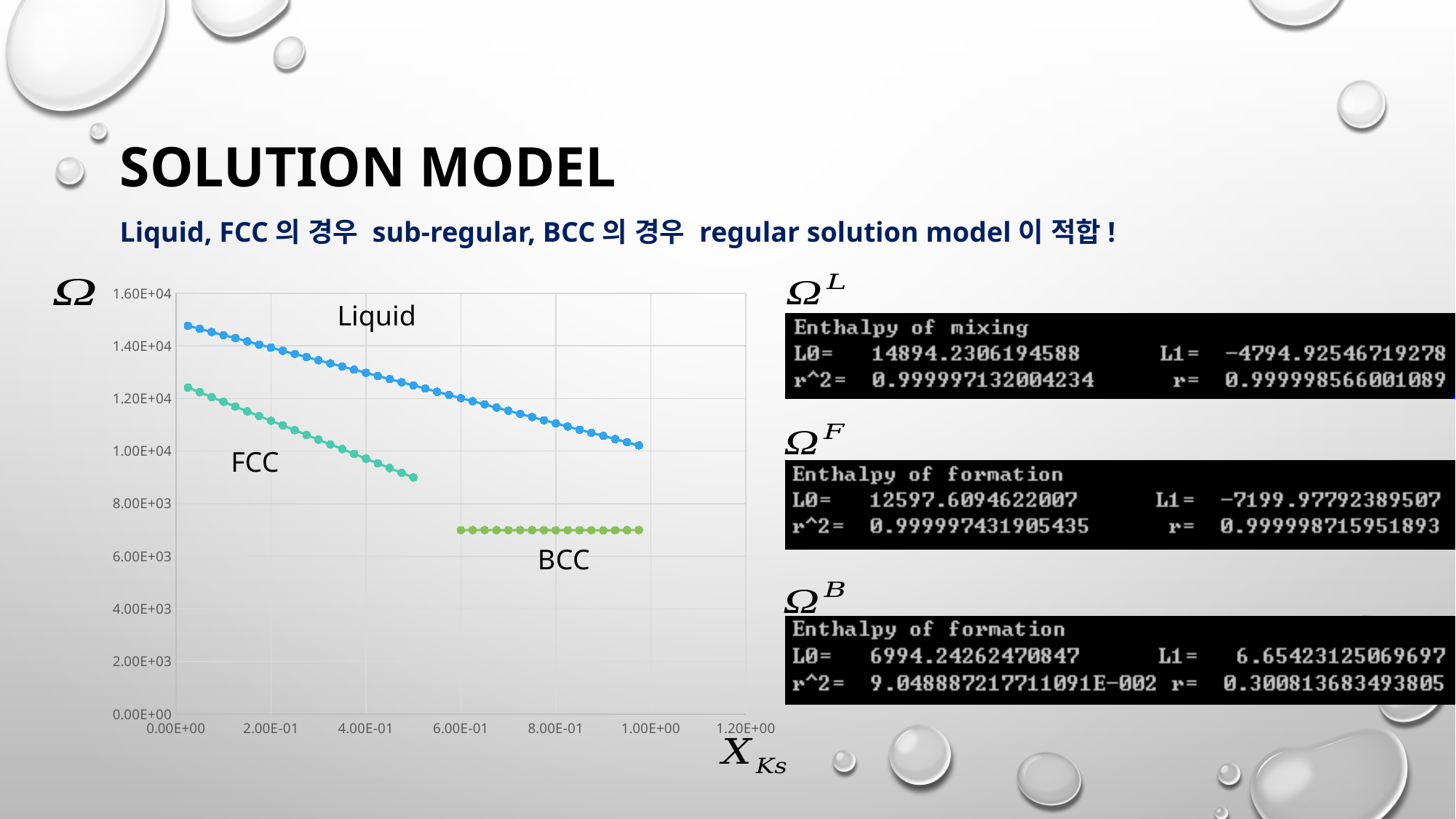
What kind of chart is shown on the slide? scatter chart What label is shown on the horizontal axis of the chart? X_Ks Is the value of the BCC series greater or less than 8.00E+03? less At X_Ks = 2.00E-01, which series has the larger value, Liquid or FCC? Liquid Do the values of the Liquid series rise or fall as X_Ks increases? fall Which series has the highest values on the chart? Liquid How many data series are labelled on the chart? 3 What is the highest tick value shown on the vertical axis? 1.60E+04 Which series has the lowest values on the chart? BCC Do the values of the FCC series rise or fall as X_Ks increases? fall